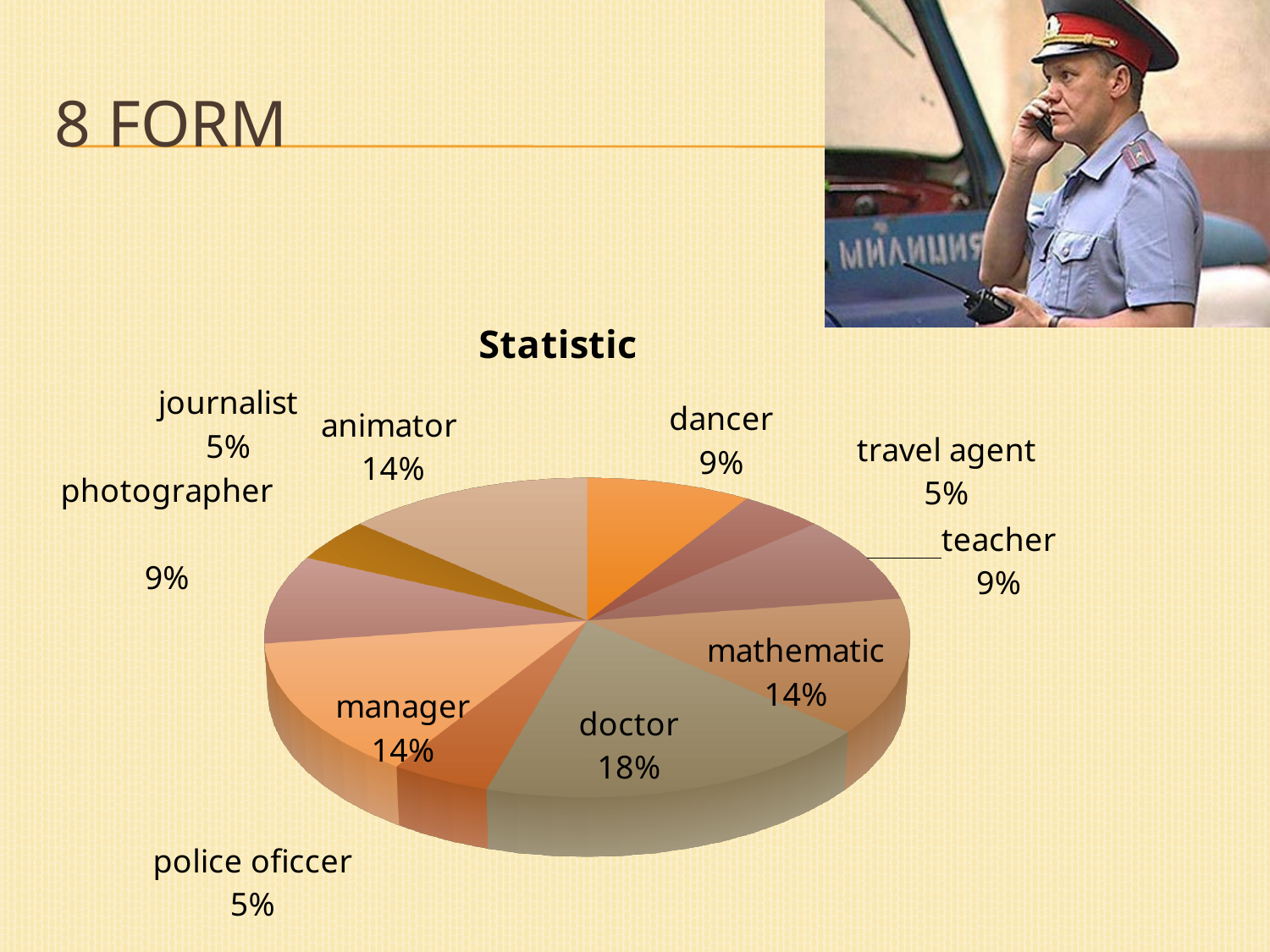
What share of the pie does doctor have? 18% What is the value for photographer? 9% What is the value for travel agent? 5% What is the value for mathematic? 14% What kind of chart is shown on the slide? pie chart Which category has the largest share of the pie? doctor Which is larger, the share for police oficcer or the share for mathematic? mathematic Which is larger, the share for manager or the share for teacher? manager What is the difference between the shares for animator and journalist? 9% How many categories does the pie chart show? 10 What is the difference between the shares for doctor and dancer? 9% What is the title of the chart? Statistic